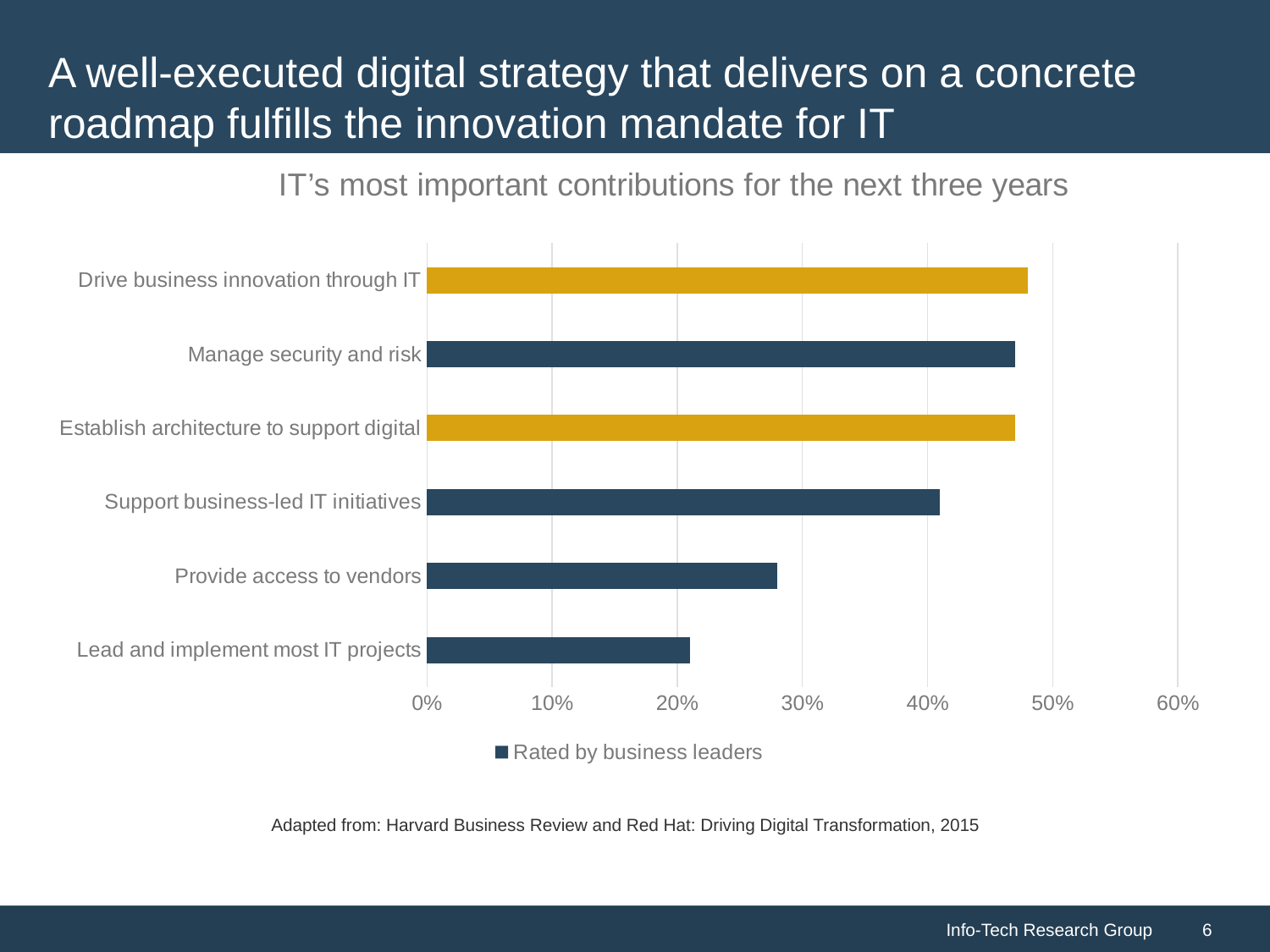
Which category has the lowest value in the chart? Lead and implement most IT projects How many series does the legend list? 1 Is the value for Provide access to vendors greater or less than 20%? greater What is the legend entry shown below the chart? Rated by business leaders What type of chart is shown on the slide? Bar chart Is the value for Support business-led IT initiatives greater or less than 30%? greater Which is larger: the value for Provide access to vendors or the value for Lead and implement most IT projects? Provide access to vendors Is the value for Drive business innovation through IT greater or less than 40%? greater How many categories are plotted in the chart? 6 What is the title of the chart? IT's most important contributions for the next three years